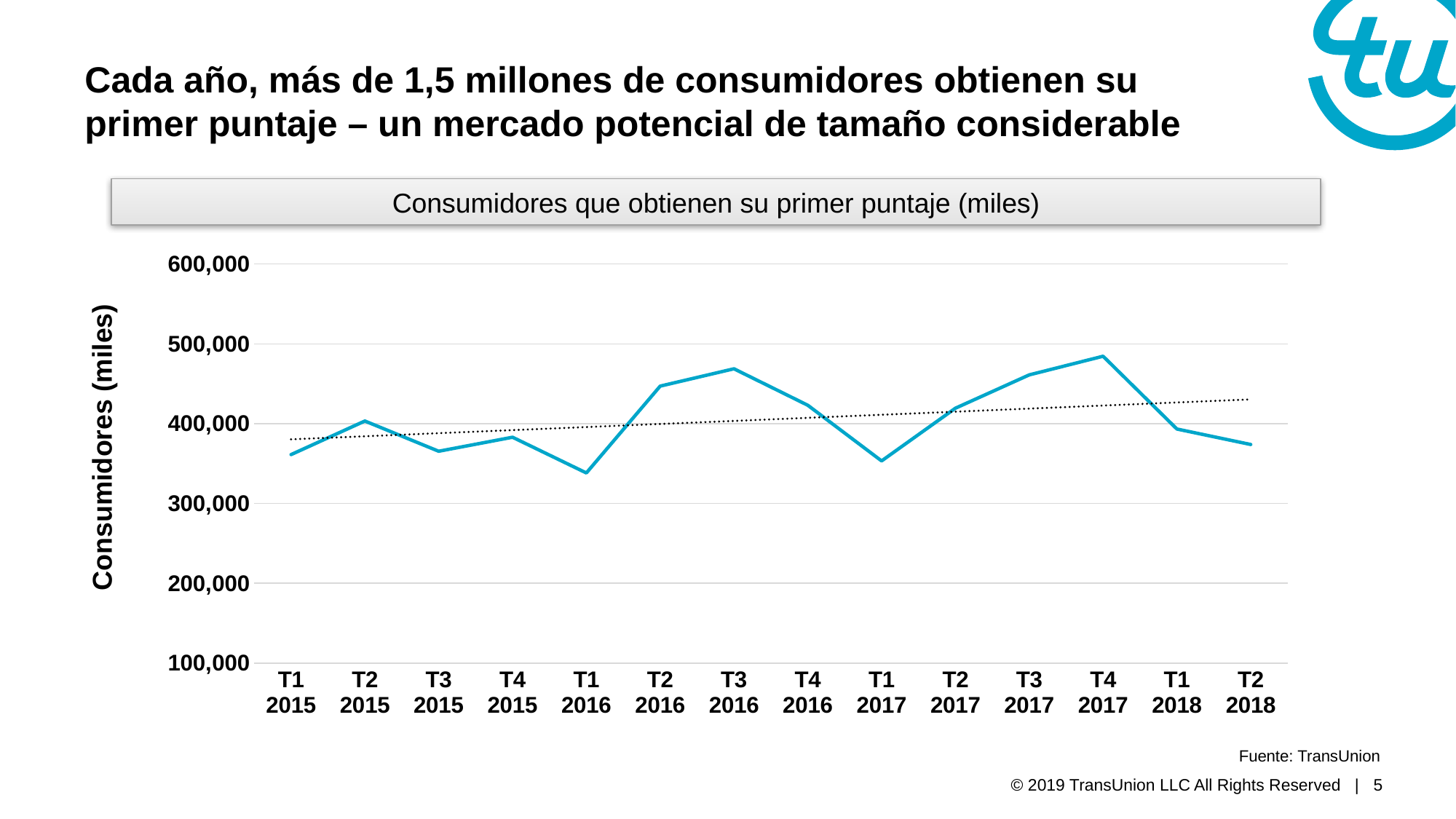
In which quarter is the number of consumers obtaining their first score lowest? T1 2016 Is the value for T1 2016 greater or less than 400,000? less Which is larger, the value for T3 2017 or the value for T1 2018? T3 2017 What kind of chart is shown on the slide? Line chart How many quarterly data points are plotted on the chart? 14 Is the value for T3 2016 greater or less than 400,000? greater What is the title of the chart? Consumidores que obtienen su primer puntaje (miles) Is the value for T1 2017 greater or less than 400,000? less Does the dotted trend line rise or fall from T1 2015 to T2 2018? Rises In which quarter is the number of consumers obtaining their first score highest? T4 2017